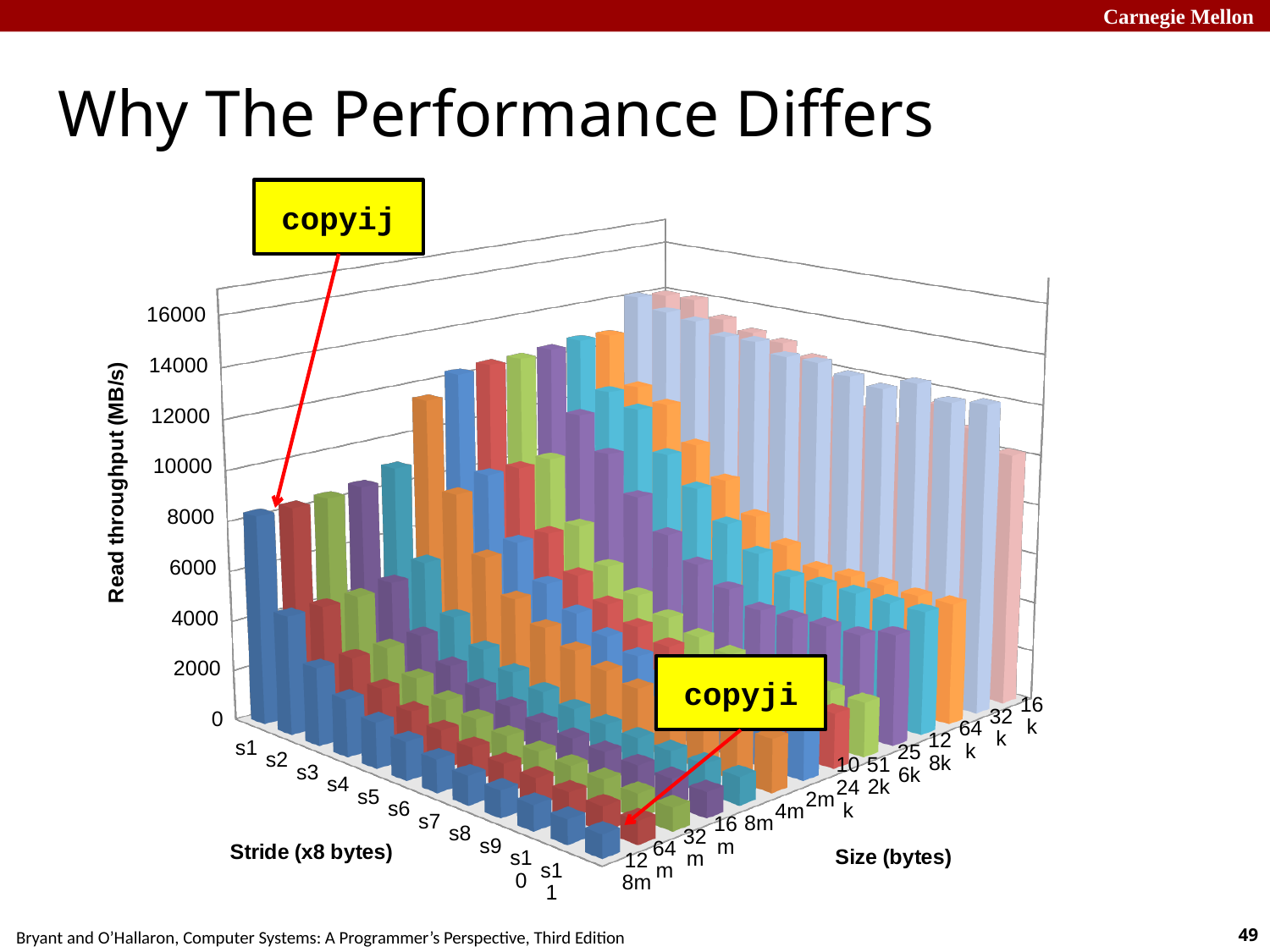
How many stride categories (s1 through s11) are shown along the stride axis? 11 What is the label of the stride axis of the chart? Stride (x8 bytes) Is the read throughput for stride s1 at size 128m greater or less than 4000? greater Is the read throughput for stride s1 at size 128m greater or less than 12000? less What is the highest tick value shown on the Read throughput axis? 16000 Along the stride axis at size 128m, does read throughput rise or fall as stride increases from s1 to s11? fall How many size categories are shown along the Size (bytes) axis? 14 What is the label of the vertical axis of the chart? Read throughput (MB/s) Is the read throughput for stride s11 at size 128m greater or less than 4000? less What kind of chart is shown on the slide? bar chart Which stride has the higher read throughput at size 128m, s1 or s11? s1